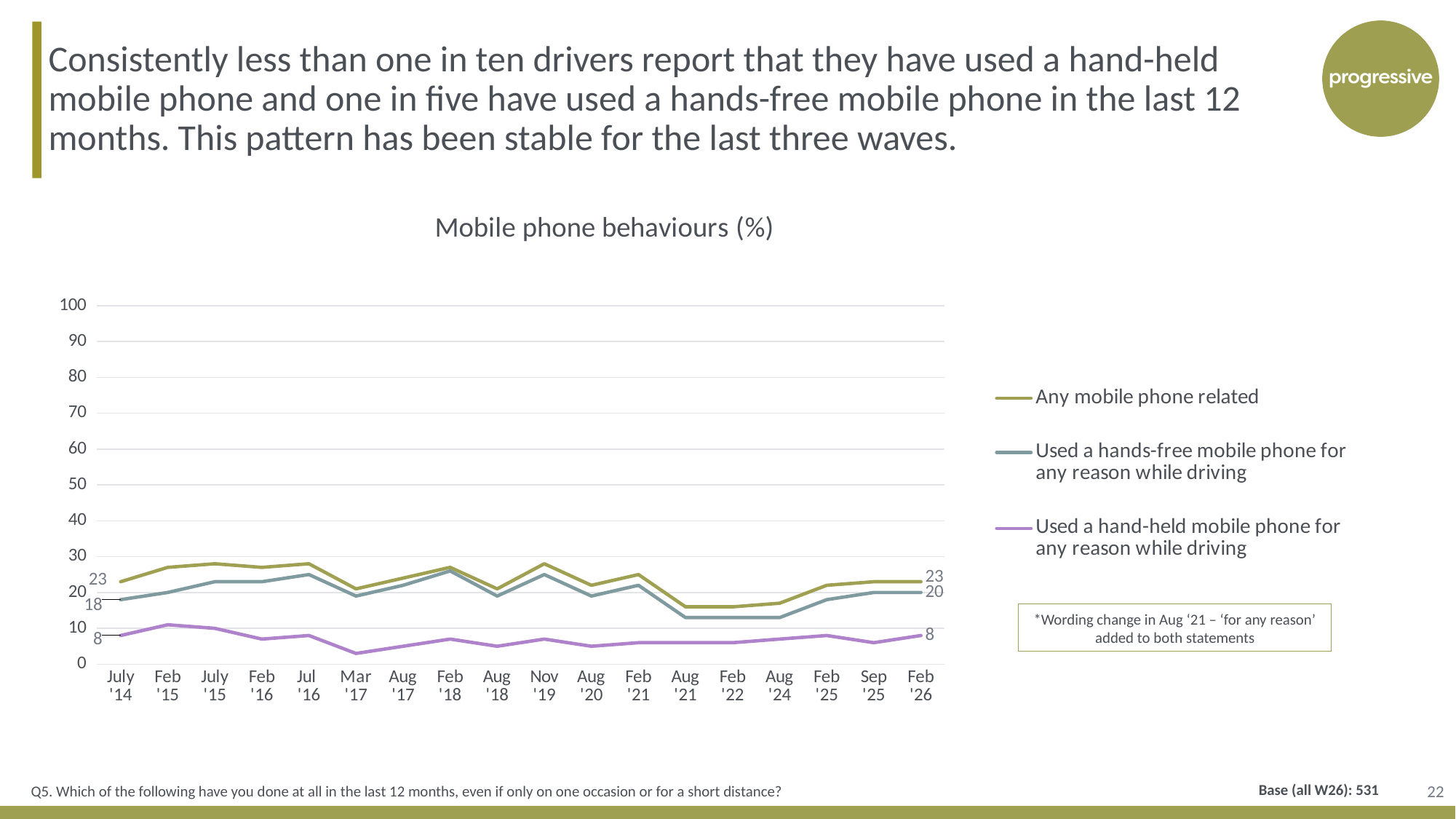
What is the value for 'Used a hands-free mobile phone for any reason while driving' in Feb '26? 20 What kind of chart is shown on the slide? line chart In Feb '26, what is the difference between 'Any mobile phone related' and 'Used a hands-free mobile phone for any reason while driving'? 3 What is the value for 'Used a hands-free mobile phone for any reason while driving' in July '14? 18 What is the value for 'Used a hand-held mobile phone for any reason while driving' in July '14? 8 How many series does the legend list? 3 In Feb '26, which is larger: the hands-free mobile phone value or the hand-held mobile phone value? hands-free mobile phone What is the title of the chart? Mobile phone behaviours (%) In July '14, what is the difference between 'Any mobile phone related' and 'Used a hands-free mobile phone for any reason while driving'? 5 Is the value for 'Any mobile phone related' in Aug '21 greater or less than 20? less What is the value for 'Any mobile phone related' in Feb '26? 23 How many time points are shown on the x axis? 18